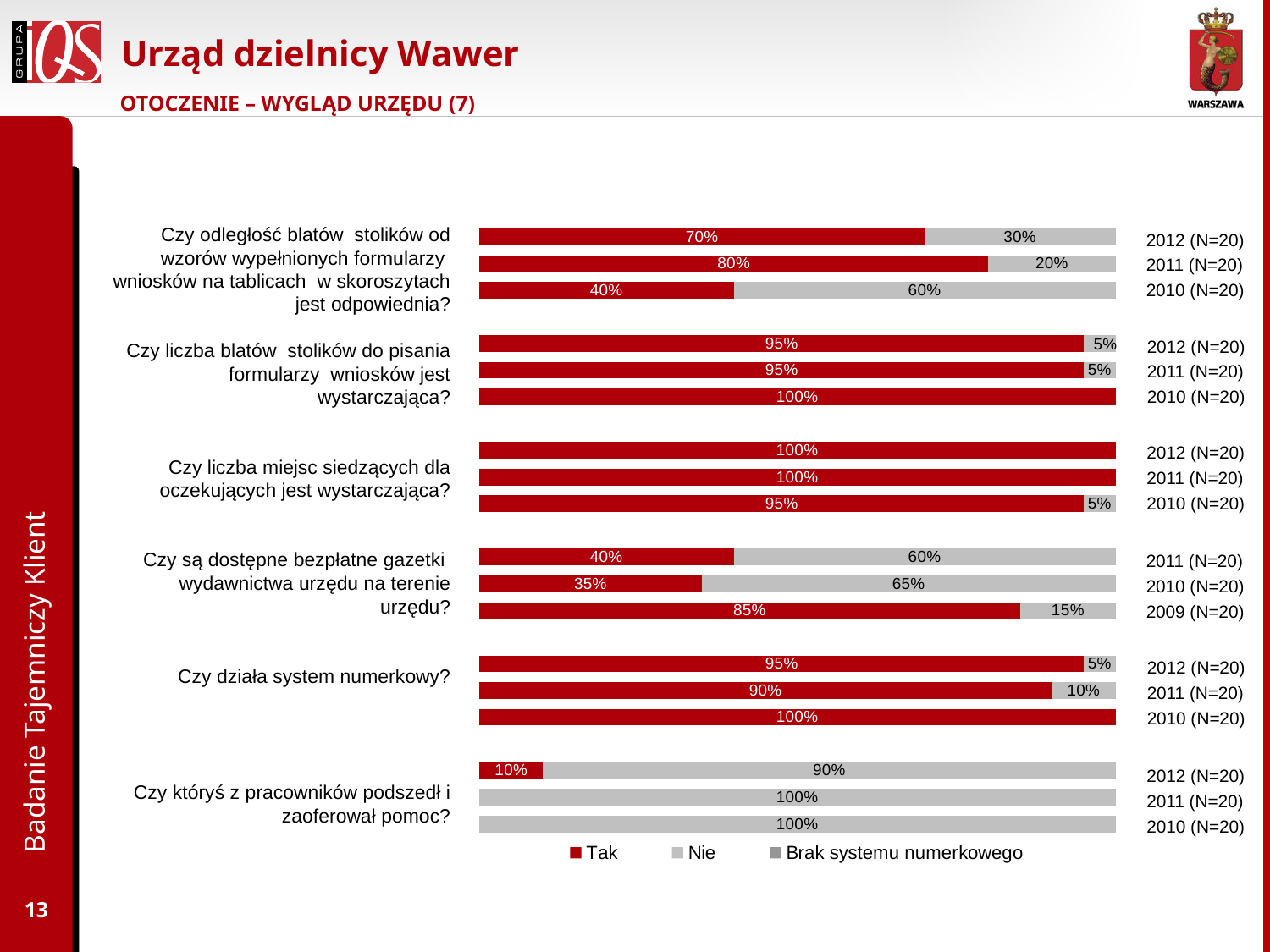
What percentage answered "Tak" to "Czy odległość blatów stolików od wzorów wypełnionych formularzy wniosków na tablicach w skoroszytach jest odpowiednia?" in 2010? 40% What percentage answered "Nie" to "Czy są dostępne bezpłatne gazetki wydawnictwa urzędu na terenie urzędu?" in 2010? 65% What kind of chart is shown on the slide? Stacked bar chart For "Czy odległość blatów stolików od wzorów wypełnionych formularzy wniosków na tablicach w skoroszytach jest odpowiednia?", what is the difference in the "Tak" share between 2011 and 2010? 40 percentage points For "Czy odległość blatów stolików od wzorów wypełnionych formularzy wniosków na tablicach w skoroszytach jest odpowiednia?", which year has the highest "Tak" share? 2011 What percentage answered "Tak" to "Czy liczba blatów stolików do pisania formularzy wniosków jest wystarczająca?" in 2010? 100% What percentage answered "Tak" to "Czy działa system numerkowy?" in 2011? 90% How many series does the legend list? 3 How many years are shown for "Czy działa system numerkowy?"? 3 What percentage answered "Nie" to "Czy któryś z pracowników podszedł i zaoferował pomoc?" in 2012? 90% What are the three legend entries of the chart? Tak, Nie, Brak systemu numerkowego For "Czy są dostępne bezpłatne gazetki wydawnictwa urzędu na terenie urzędu?", which year has the larger "Tak" share, 2009 or 2011? 2009